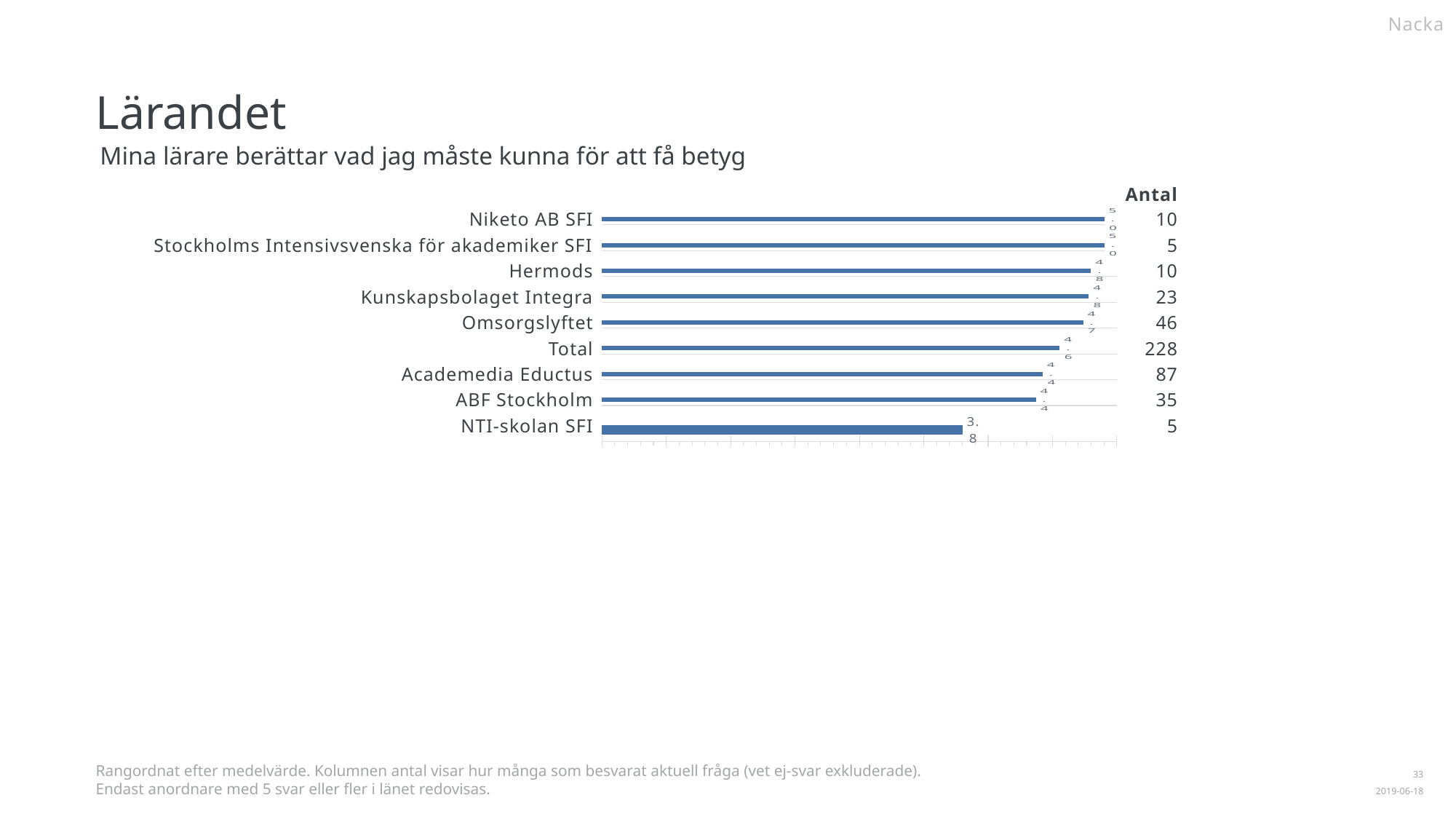
What is the value for NTI-skolan SFI? 3.8 How many categories (bars) does the chart show? 9 Which is larger, the value for Omsorgslyftet or the value for ABF Stockholm? Omsorgslyftet What is the difference between the value for Total and the value for NTI-skolan SFI? 0.8 What is the subtitle (question text) shown above the chart? Mina lärare berättar vad jag måste kunna för att få betyg Which category has the highest Antal (number of respondents)? Total What is the value for Total? 4.6 What is the Antal (number of respondents) for Total? 228 What is the Antal (number of respondents) for Academedia Eductus? 87 What is the value for Omsorgslyftet? 4.7 What kind of chart is shown on the slide? bar chart Which category has the lowest value? NTI-skolan SFI